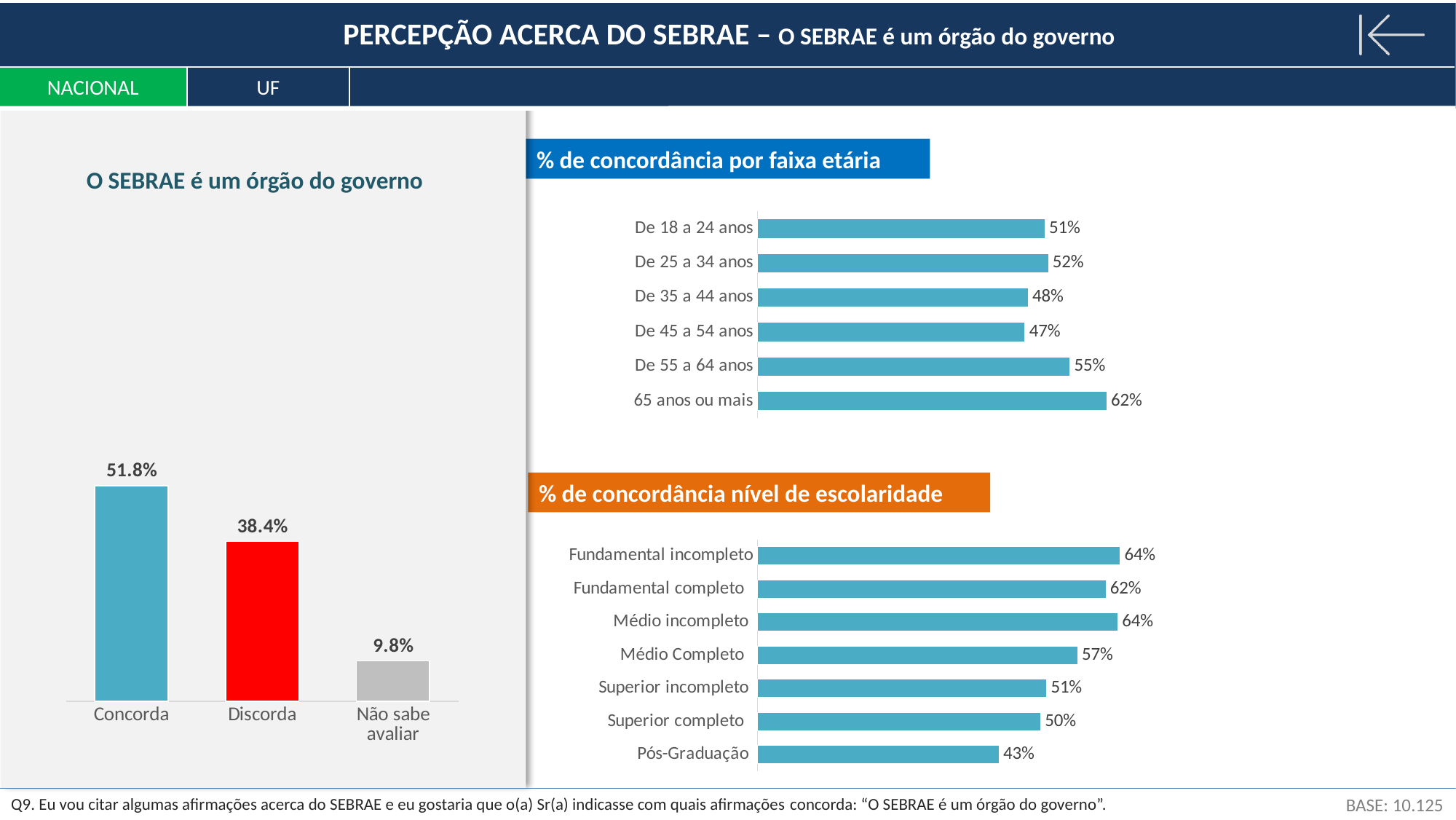
In the chart titled '% de concordância por faixa etária', what is the value for De 55 a 64 anos? 55% In the chart titled 'O SEBRAE é um órgão do governo', what is the value for Não sabe avaliar? 9.8% In the chart titled 'O SEBRAE é um órgão do governo', how many categories are shown? 3 In the chart titled '% de concordância nível de escolaridade', which category has the lowest value? Pós-Graduação In the chart titled '% de concordância nível de escolaridade', what is the value for Médio Completo? 57% In the chart titled '% de concordância por faixa etária', how many age groups are shown? 6 In the chart titled '% de concordância nível de escolaridade', which is larger: Superior incompleto or Superior completo? Superior incompleto In the chart titled 'O SEBRAE é um órgão do governo', what is the value for Concorda? 51.8% What kind of chart is '% de concordância nível de escolaridade'? Bar chart In the chart titled 'O SEBRAE é um órgão do governo', what is the difference between Concorda and Discorda? 13.4 percentage points In the chart titled '% de concordância por faixa etária', which age group has the lowest value? De 45 a 54 anos In the chart titled '% de concordância por faixa etária', which age group has the highest value? 65 anos ou mais